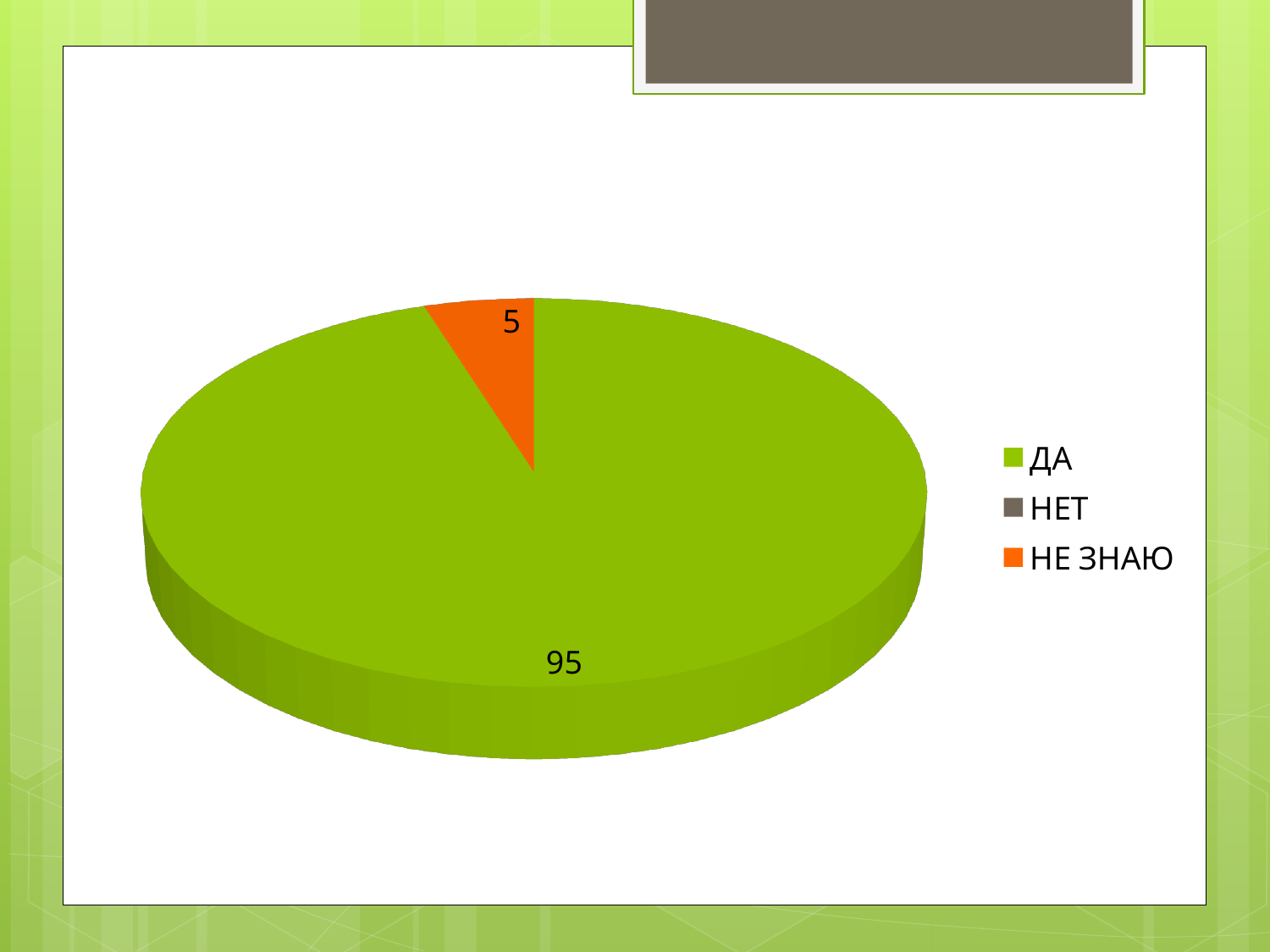
What share of the labelled total does the ДА slice represent? 95% Which legend entry is shown in orange? НЕ ЗНАЮ What value is shown for the НЕ ЗНАЮ slice of the pie chart? 5 How many entries does the legend of the pie chart list? 3 What colour is the ДА slice in the pie chart? Green Which of the two labelled slices, ДА or НЕ ЗНАЮ, is smaller? НЕ ЗНАЮ What is the difference between the values for ДА and НЕ ЗНАЮ? 90 What value is shown for the ДА slice of the pie chart? 95 What is the total of the two values labelled on the pie chart? 100 Which is larger, the value for ДА or the value for НЕ ЗНАЮ? ДА Which category has the largest slice in the pie chart? ДА What kind of chart is shown on the slide? Pie chart